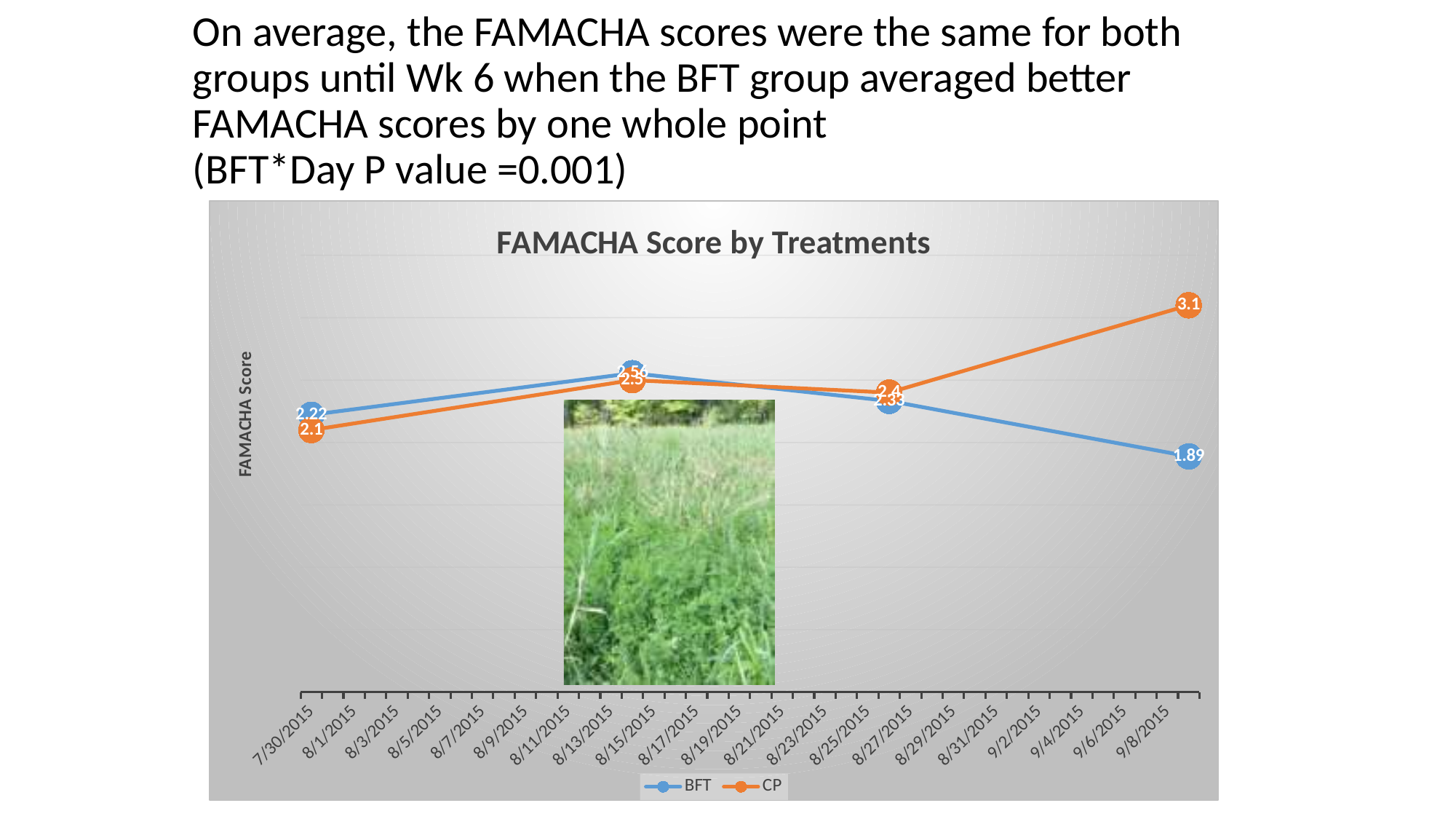
Does the CP line rise or fall between its last two data points? rise What is the CP FAMACHA score on 9/8/2015? 3.1 On 9/8/2015, how much higher is the CP score than the BFT score? 1.21 What is the BFT FAMACHA score on 7/30/2015? 2.22 What kind of chart is shown on the slide? line chart What is the lowest FAMACHA score plotted for the BFT series? 1.89 How many series does the legend of the FAMACHA Score by Treatments chart list? 2 What is the CP FAMACHA score on 7/30/2015? 2.1 On 9/8/2015, which group has the higher FAMACHA score, BFT or CP? CP What is the BFT FAMACHA score on 9/8/2015? 1.89 What is the highest FAMACHA score plotted for the CP series? 3.1 How many data points are plotted for each series in the chart? 4